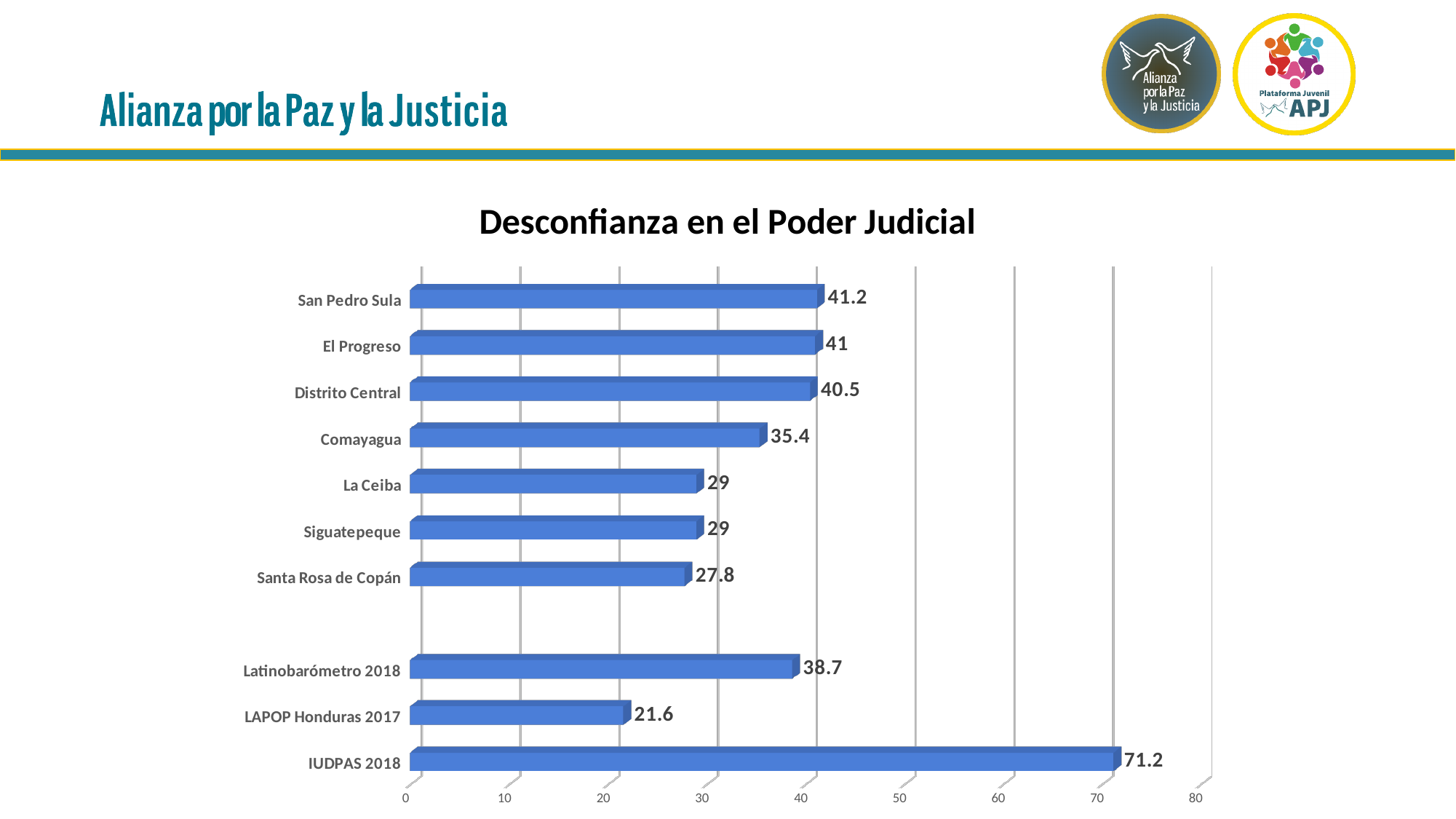
Which category has the lowest value? LAPOP Honduras 2017 Is the value for Distrito Central greater or less than 40? greater What is the value for San Pedro Sula? 41.2 What is the value for LAPOP Honduras 2017? 21.6 What is the value for Santa Rosa de Copán? 27.8 What is the title of the chart? Desconfianza en el Poder Judicial How many bars are plotted in the chart? 10 What is the value for Comayagua? 35.4 What is the difference between the values for IUDPAS 2018 and Latinobarómetro 2018? 32.5 Which category has the highest value? IUDPAS 2018 Which is larger, the value for Comayagua or the value for La Ceiba? Comayagua What kind of chart is shown on the slide? bar chart